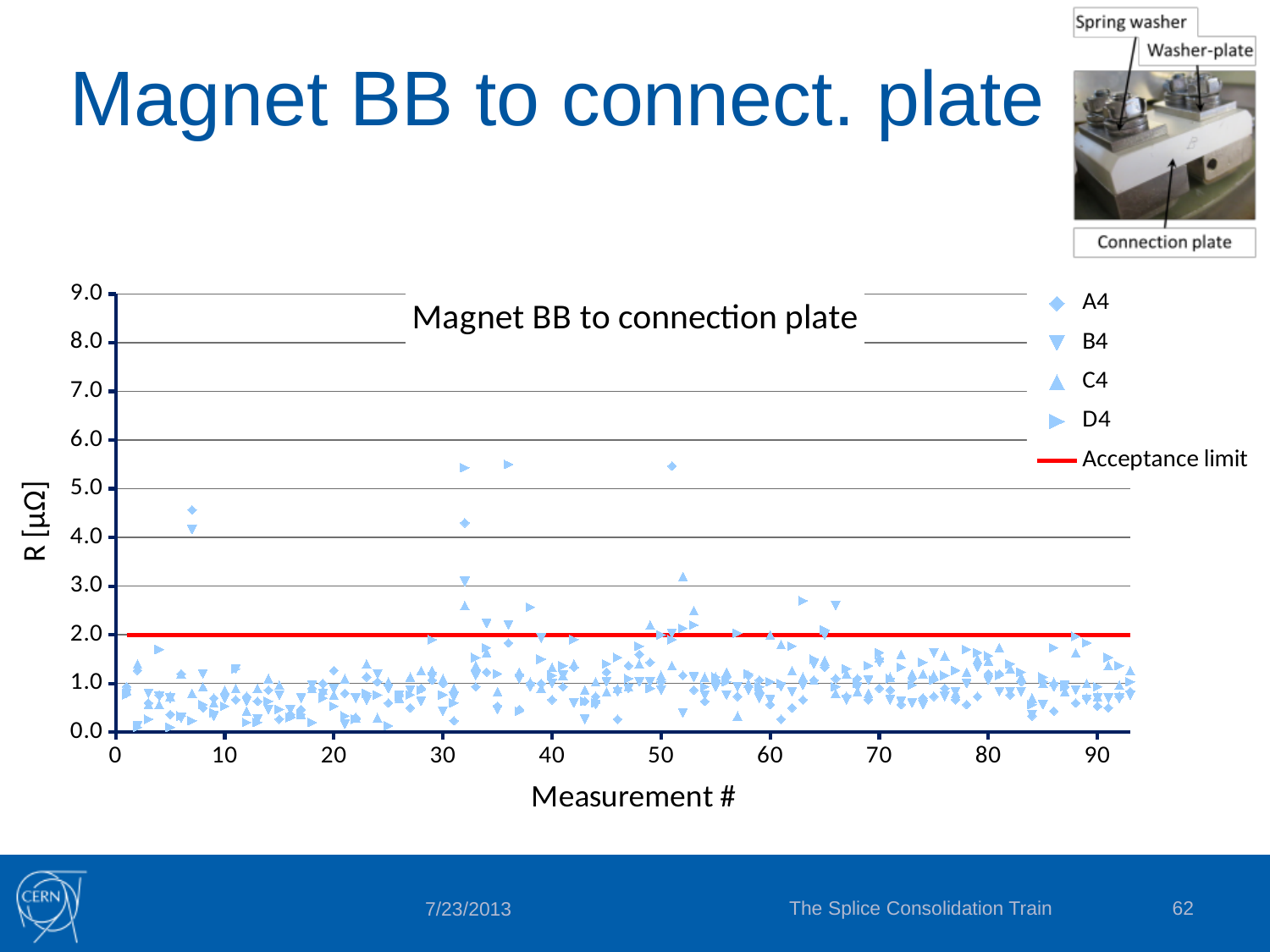
What is the label of the y axis? R [µΩ] Is the highest plotted measurement value greater or less than 5.0? greater Is the Acceptance limit greater or less than 3.0? less What kind of chart is shown on the slide? scatter chart At what value on the y axis is the Acceptance limit line drawn? 2.0 What is the highest tick value shown on the x axis? 90 What is the title of the chart? Magnet BB to connection plate Which legend entry is drawn as a red line rather than markers? Acceptance limit What is the highest tick value shown on the y axis? 9.0 What is the label of the x axis? Measurement # How many entries does the chart legend list? 5